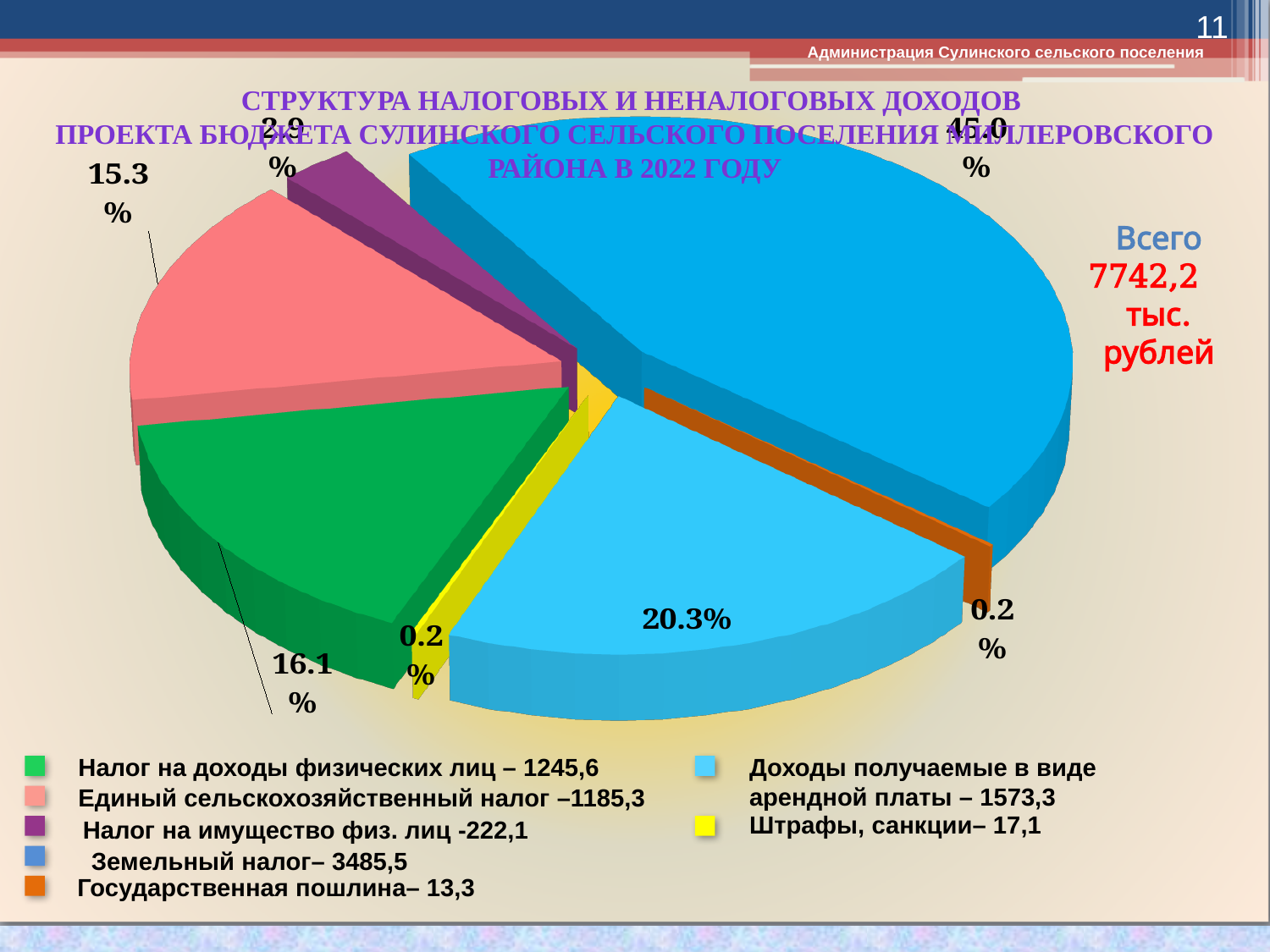
What is the value for Земельный налог given in the legend? 3485,5 Which category has the largest slice of the pie? Земельный налог What total amount (Всего) is stated next to the pie chart? 7742,2 тыс. рублей What share of the pie does Налог на имущество физ. лиц (the purple slice) represent? 2.9% What share of the pie does Земельный налог (the blue slice) represent? 45.0% How many categories does the legend list? 7 What share of the pie does Доходы получаемые в виде арендной платы (the light blue slice) represent? 20.3% Which is larger: the slice for Налог на доходы физических лиц or the slice for Единый сельскохозяйственный налог? Налог на доходы физических лиц What is the value for Штрафы, санкции given in the legend? 17,1 What kind of chart is shown on the slide? pie chart